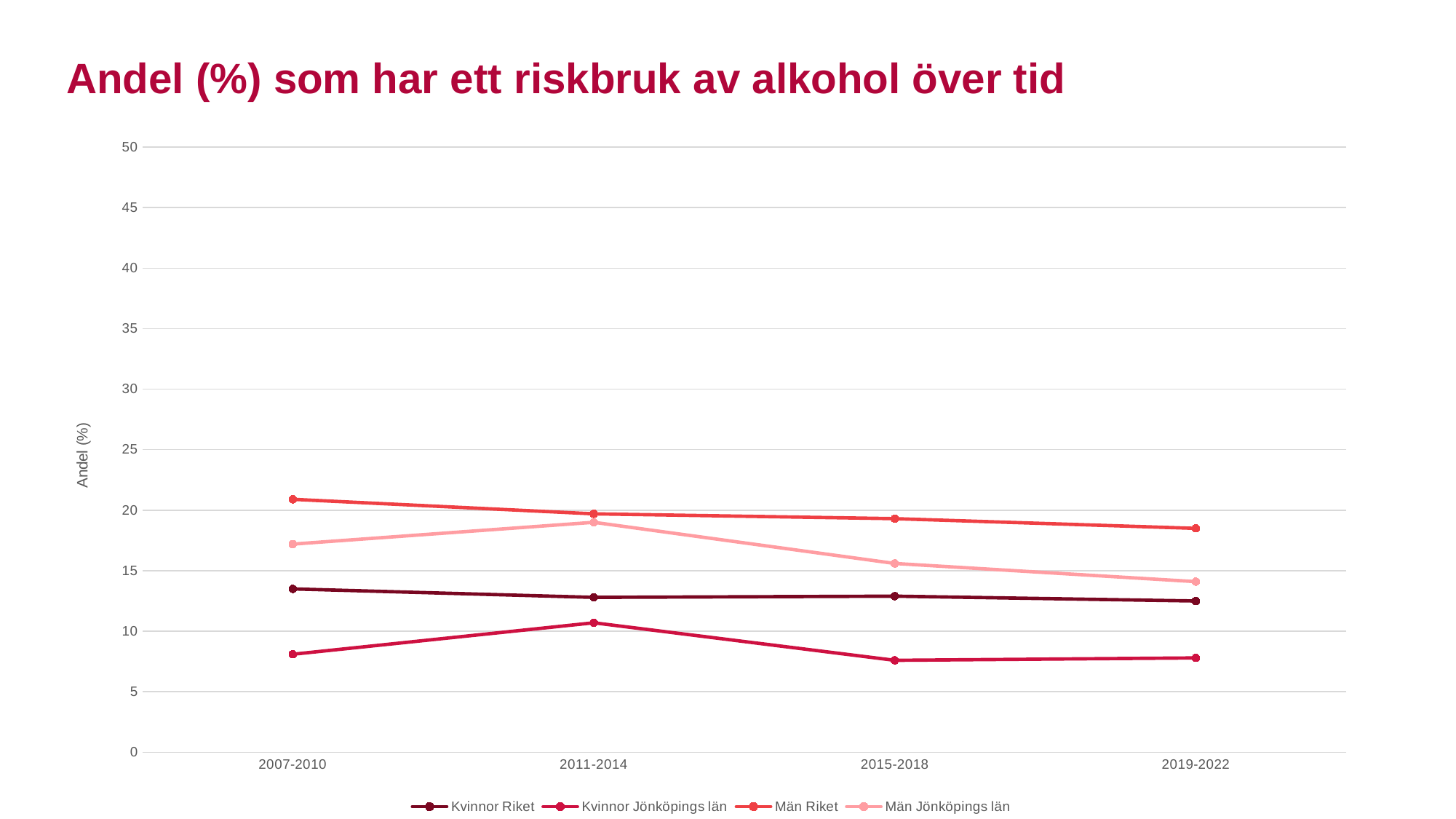
Which series has the highest value in 2007-2010? Män Riket How many time periods are shown on the x axis? 4 In 2015-2018, which is larger: Män Riket or Män Jönköpings län? Män Riket Does the value for Män Riket rise or fall from 2007-2010 to 2019-2022? fall Which series has the lowest value in 2019-2022? Kvinnor Jönköpings län What is the label on the y axis? Andel (%) Is the value for Kvinnor Jönköpings län in 2011-2014 greater or less than 10? greater In which period does Kvinnor Jönköpings län reach its highest value? 2011-2014 Is the value for Män Riket in 2007-2010 greater or less than 20? greater Is the value for Män Jönköpings län in 2019-2022 greater or less than 15? less What kind of chart is shown on the slide? line chart How many series does the legend list? 4